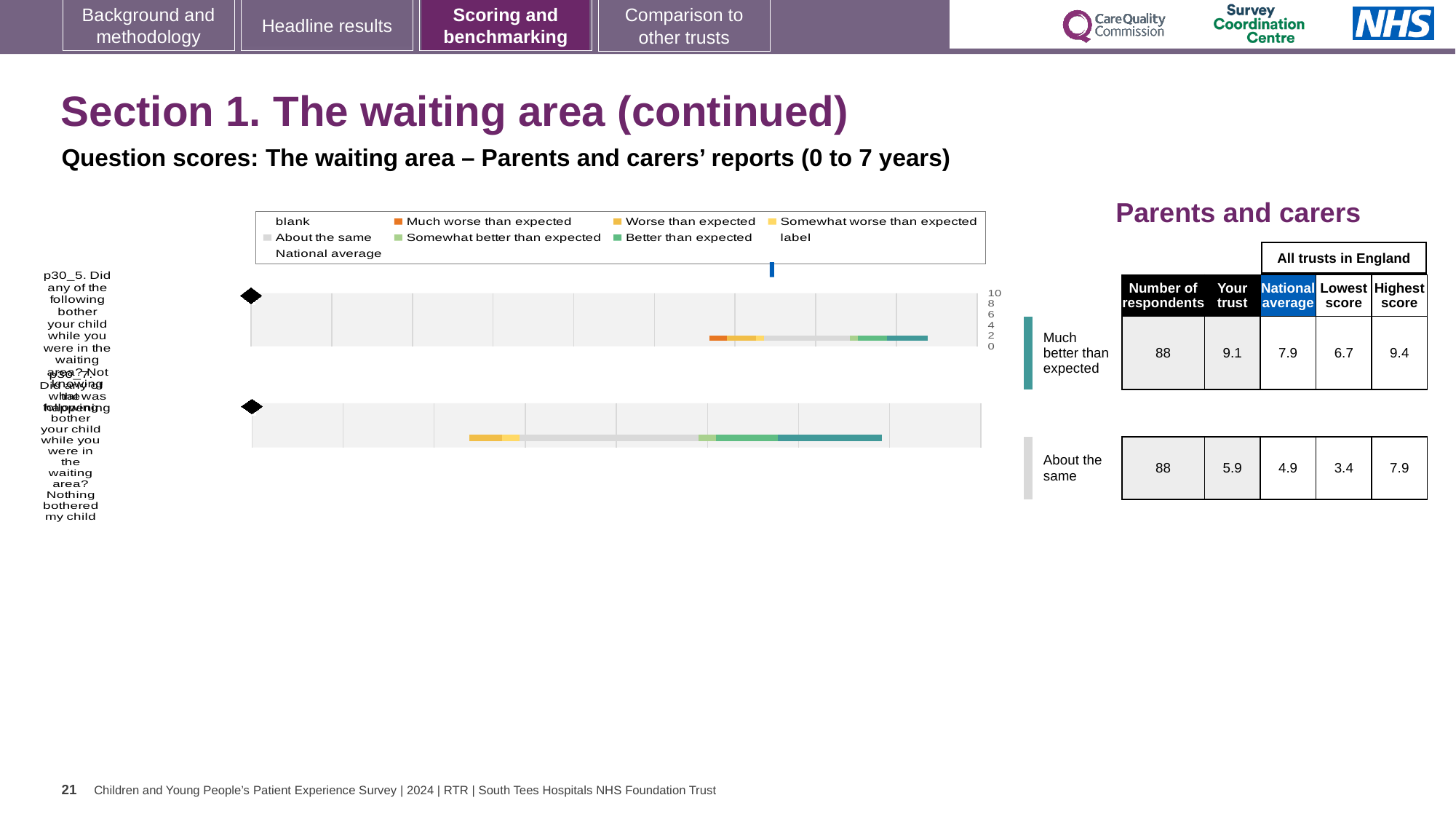
In the table, what is the national average for the question rated 'About the same'? 4.9 What kind of chart is shown on the slide? bar chart How many entries does the chart legend list? 9 In the table, how many respondents answered the question rated 'Much better than expected'? 88 For the question rated 'Much better than expected', what is the difference between the 'Your trust' score and the national average? 1.2 In the table, what is the highest score across all trusts in England for the question rated 'Much better than expected'? 9.4 What colour does the legend use for 'Much worse than expected'? orange What is the highest value shown on the chart's axis? 10 In the table, what is the 'Your trust' score for the question rated 'Much better than expected'? 9.1 How many questions (bars) are plotted in the chart? 2 For the question rated 'About the same', which is larger: the 'Your trust' score or the national average? Your trust For the question rated 'About the same', what is the difference between the highest score and the lowest score across all trusts in England? 4.5